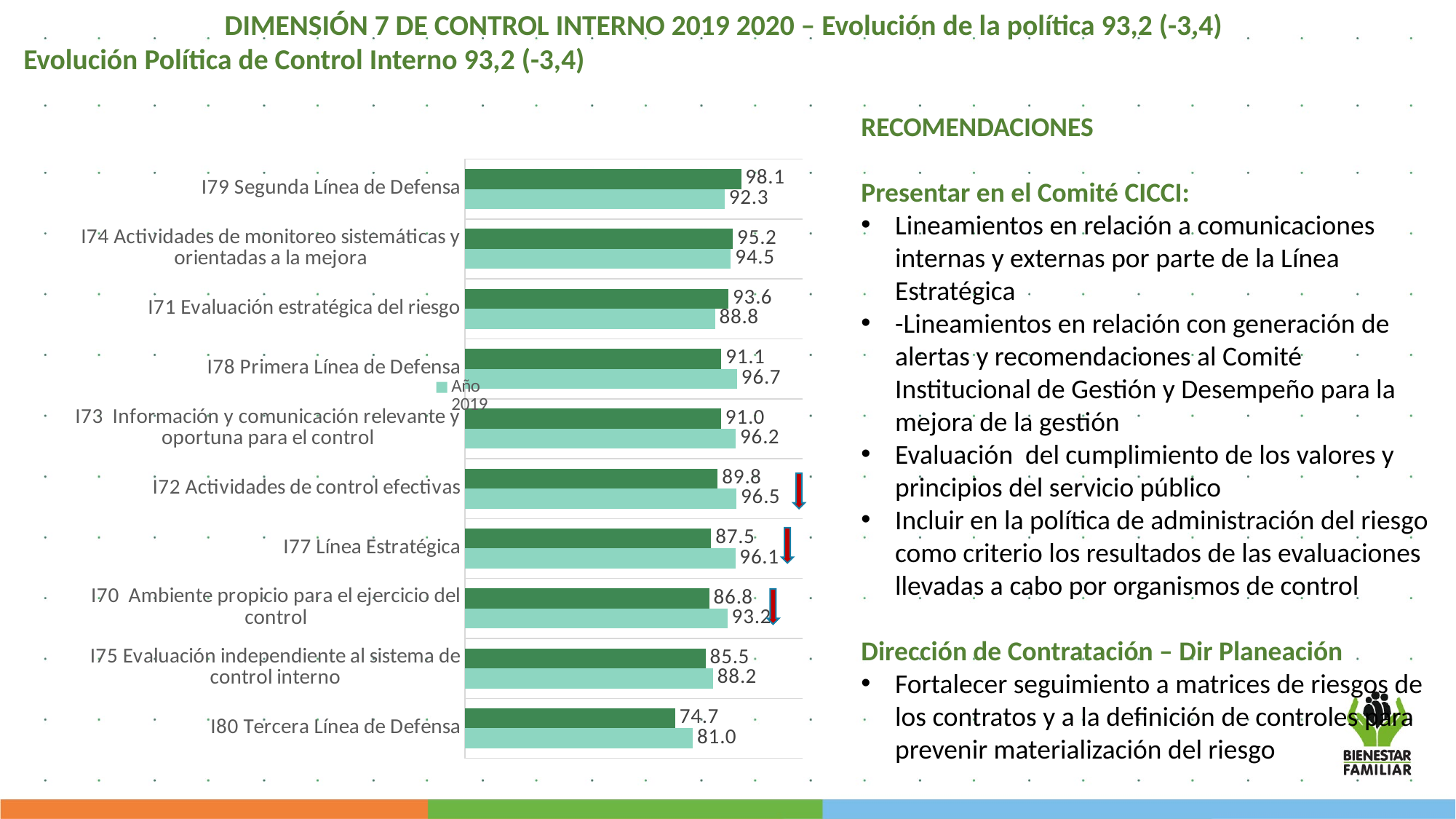
Which category has the highest dark green bar value? I79 Segunda Línea de Defensa Which legend entry is readable on the chart? Año 2019 What is the value of the light green (Año 2019) bar for I80 Tercera Línea de Defensa? 81.0 What is the difference between the dark green and light green bars for I70 Ambiente propicio para el ejercicio del control? 6.4 What is the value of the dark green bar for I79 Segunda Línea de Defensa? 98.1 What is the difference between the dark green and light green bars for I78 Primera Línea de Defensa? 5.6 For I72 Actividades de control efectivas, which bar is larger: the dark green bar or the light green (Año 2019) bar? the light green (Año 2019) bar How many categories (indicators) are plotted in the chart? 10 Which category has the lowest light green (Año 2019) bar value? I80 Tercera Línea de Defensa What type of chart is shown on the slide? bar chart What is the value of the light green (Año 2019) bar for I77 Línea Estratégica? 96.1 What is the value of the dark green bar for I75 Evaluación independiente al sistema de control interno? 85.5